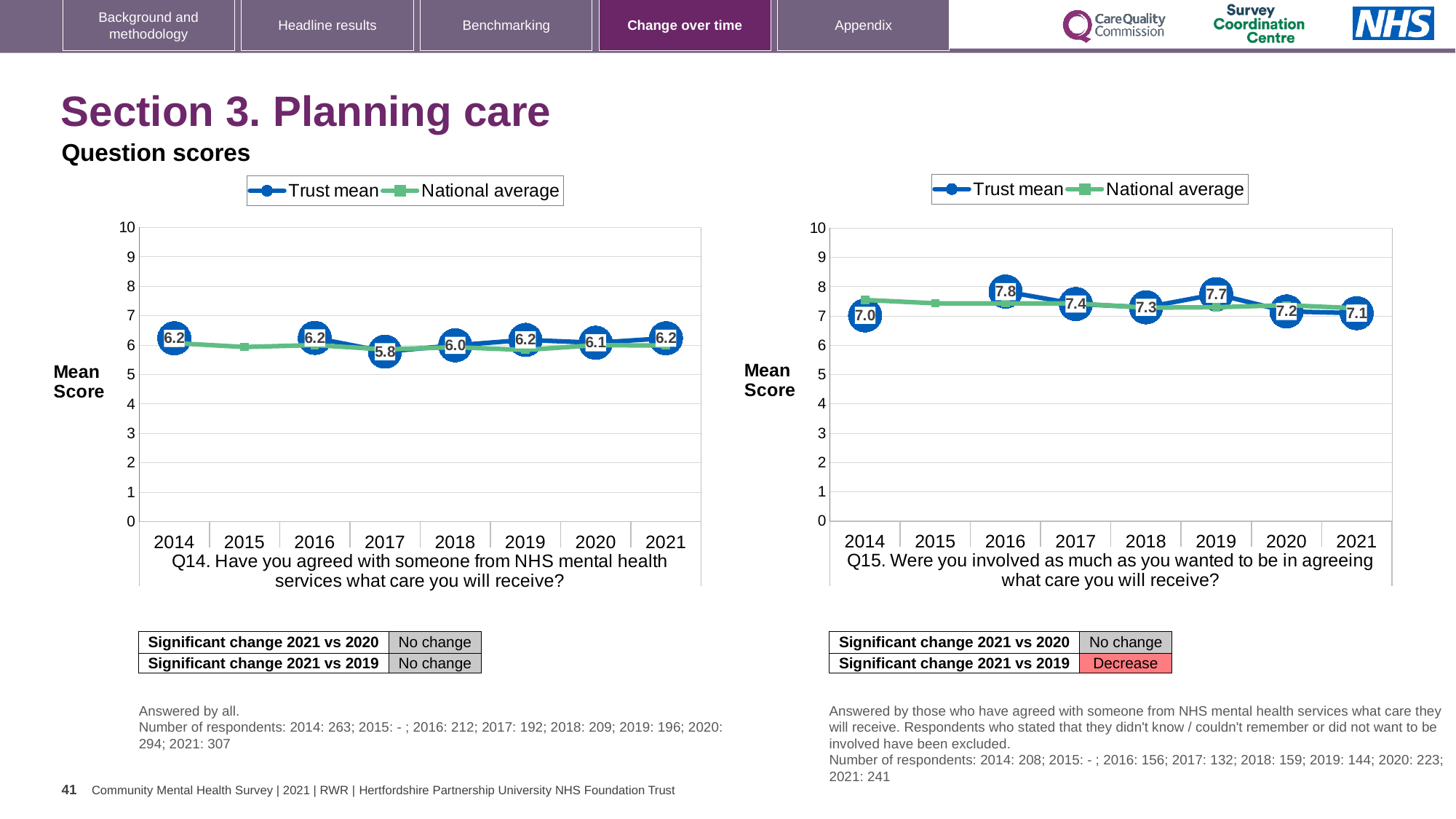
In the Q15 chart (right), what is the Trust mean for 2016? 7.8 In the Q14 chart (left), what is the Trust mean for 2017? 5.8 What kind of chart is the Q15 chart (right)? Line chart In the Q15 chart (right), which year has the lowest Trust mean? 2014 In the Q15 chart (right), which year has the highest Trust mean? 2016 In the Q15 chart (right), what is the difference between the Trust mean in 2016 and in 2021? 0.7 In the Q14 chart (left), what is the Trust mean for 2021? 6.2 In the Q14 chart (left), is the Trust mean higher in 2018 or in 2019? 2019 In the Q15 chart (right), what is the Trust mean for 2021? 7.1 In the Q15 chart (right), is the National average for 2014 greater or less than 7? greater In the Q14 chart (left), which year has the lowest Trust mean? 2017 How many series does the legend of the Q14 chart (left) list? 2